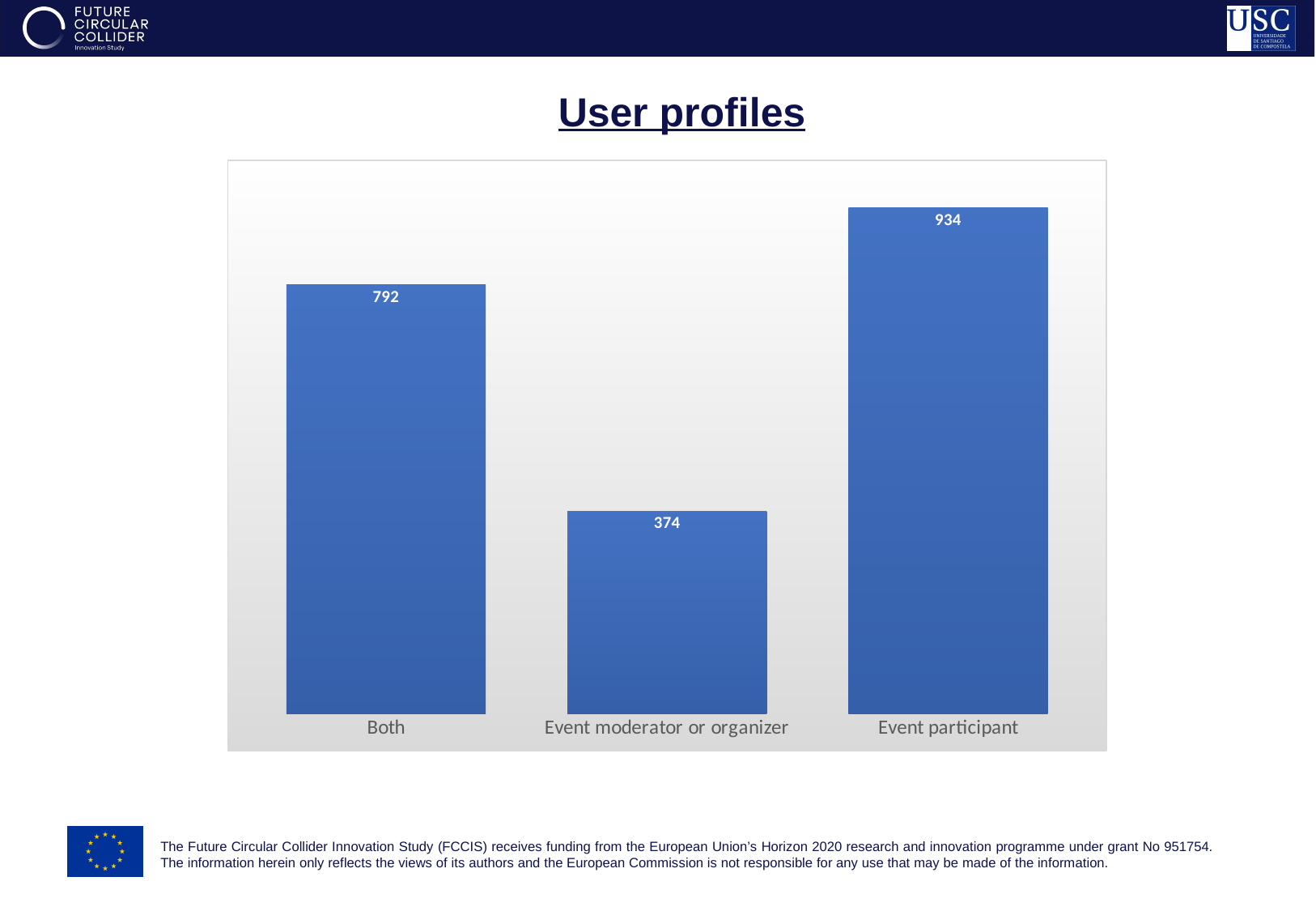
What is the title of the slide above the chart? User profiles Which category has the highest value? Event participant What is the total of the three values shown in the chart? 2100 What is the value for Event participant? 934 What is the difference between the values for Event participant and Both? 142 What is the value for Event moderator or organizer? 374 What is the value for Both? 792 What is the difference between the values for Both and Event moderator or organizer? 418 How many categories are shown in the chart? 3 Which is larger, the value for Both or the value for Event moderator or organizer? Both Which category has the lowest value? Event moderator or organizer What kind of chart is shown on the slide? Bar chart